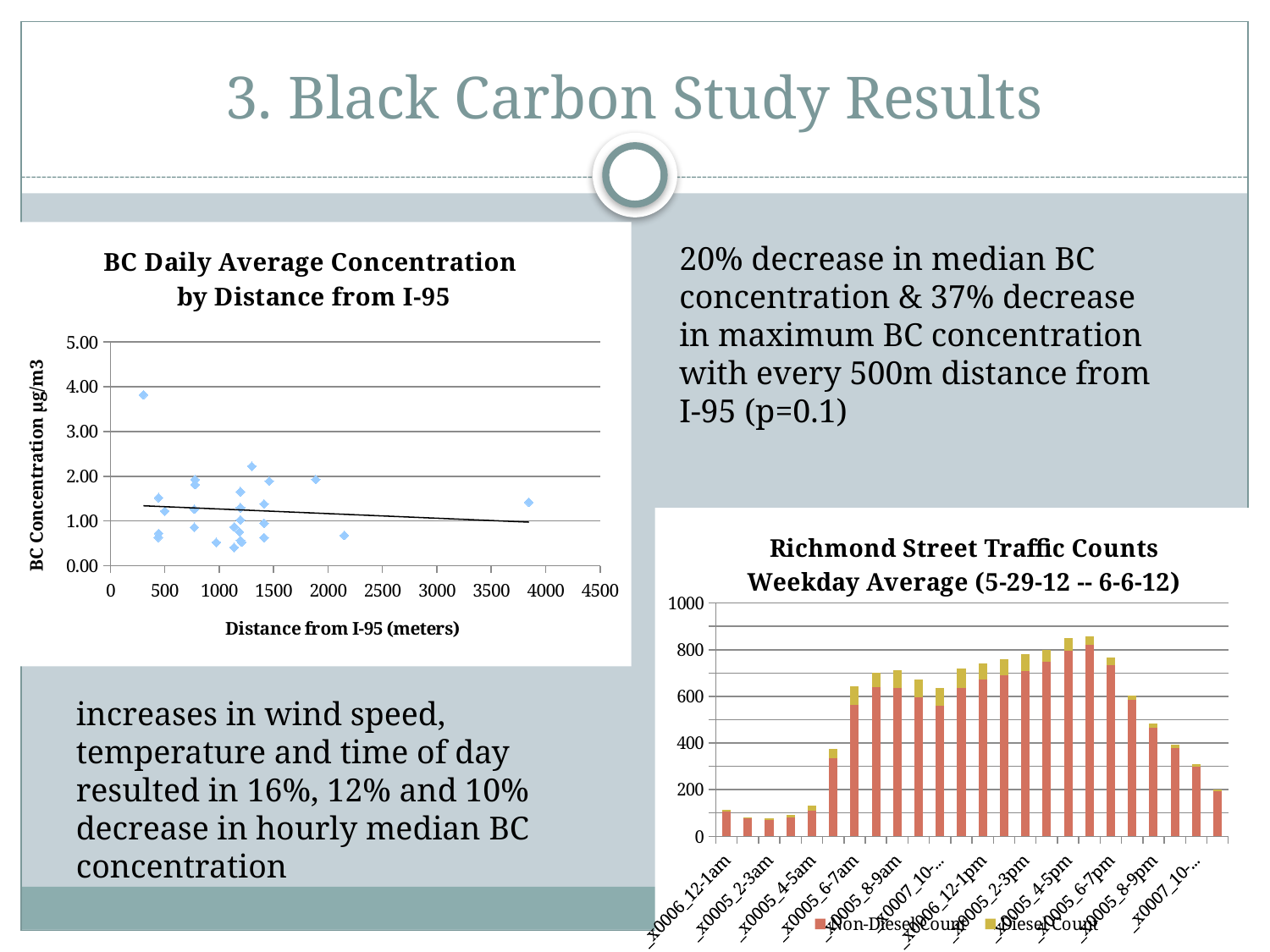
In the 'Richmond Street Traffic Counts' chart, is the total for the 4-5am bar greater or less than 200? less What kind of chart is the 'Richmond Street Traffic Counts' chart? bar chart In the 'BC Daily Average Concentration by Distance from I-95' chart, does the fitted trend line rise or fall as distance from I-95 increases? fall How many bars are plotted in the 'Richmond Street Traffic Counts' chart? 24 What is the x-axis title of the 'BC Daily Average Concentration by Distance from I-95' chart? Distance from I-95 (meters) What kind of chart is the 'BC Daily Average Concentration by Distance from I-95' chart? scatter chart In the 'Richmond Street Traffic Counts' chart, which series is shown in red? Non-Diesel Count In the 'Richmond Street Traffic Counts' chart, which bar is taller: 8-9am or 8-9pm? 8-9am In the 'BC Daily Average Concentration by Distance from I-95' chart, is the point plotted near 3850 meters greater or less than 1.00? greater In the 'BC Daily Average Concentration by Distance from I-95' chart, is the highest plotted point (near 300 meters) greater or less than 3.00? greater How many series does the legend of the 'Richmond Street Traffic Counts' chart list? 2